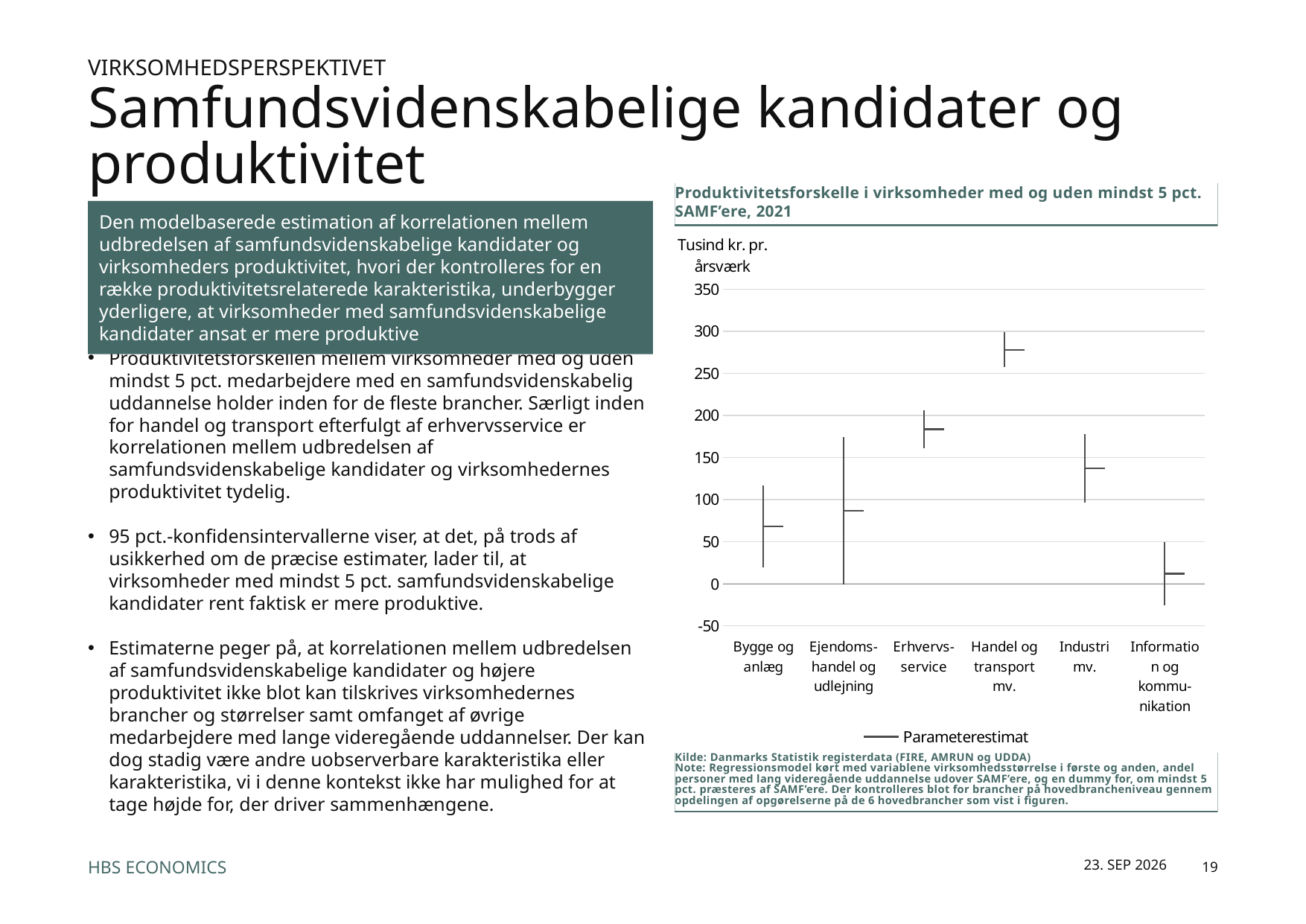
What is the single entry listed in the chart's legend? Parameterestimat Is the parameter estimate for Ejendomshandel og udlejning greater or less than 100? less Is the parameter estimate for Handel og transport mv. greater or less than 250? greater What is the unit shown on the y axis of the chart? Tusind kr. pr. årsværk Which category has the lowest parameter estimate? Information og kommunikation Which category has the highest parameter estimate? Handel og transport mv. Is the parameter estimate for Erhvervsservice greater or less than 200? less Which has the larger parameter estimate, Handel og transport mv. or Bygge og anlæg? Handel og transport mv. Which has the larger parameter estimate, Erhvervsservice or Industri mv.? Erhvervsservice How many industry categories are shown on the x axis? 6